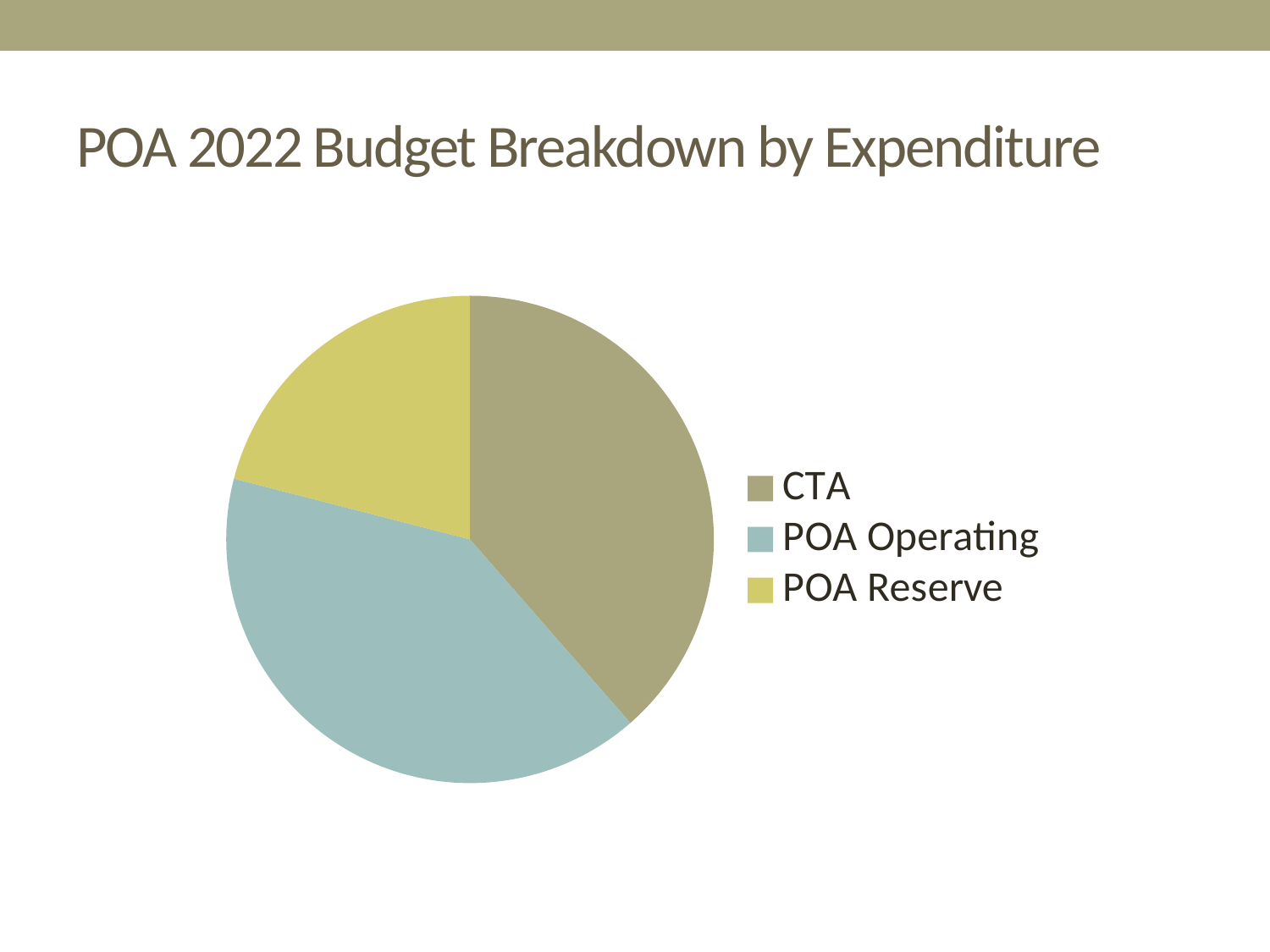
How many slices does the pie chart have? 3 Which category is shown in the yellow slice? POA Reserve What kind of chart is shown on the slide? pie chart Which category has the smallest slice of the pie? POA Reserve How many entries does the legend list? 3 What is the title of the slide containing the pie chart? POA 2022 Budget Breakdown by Expenditure Which slice is larger, CTA or POA Reserve? CTA Which slice is larger, POA Operating or POA Reserve? POA Operating